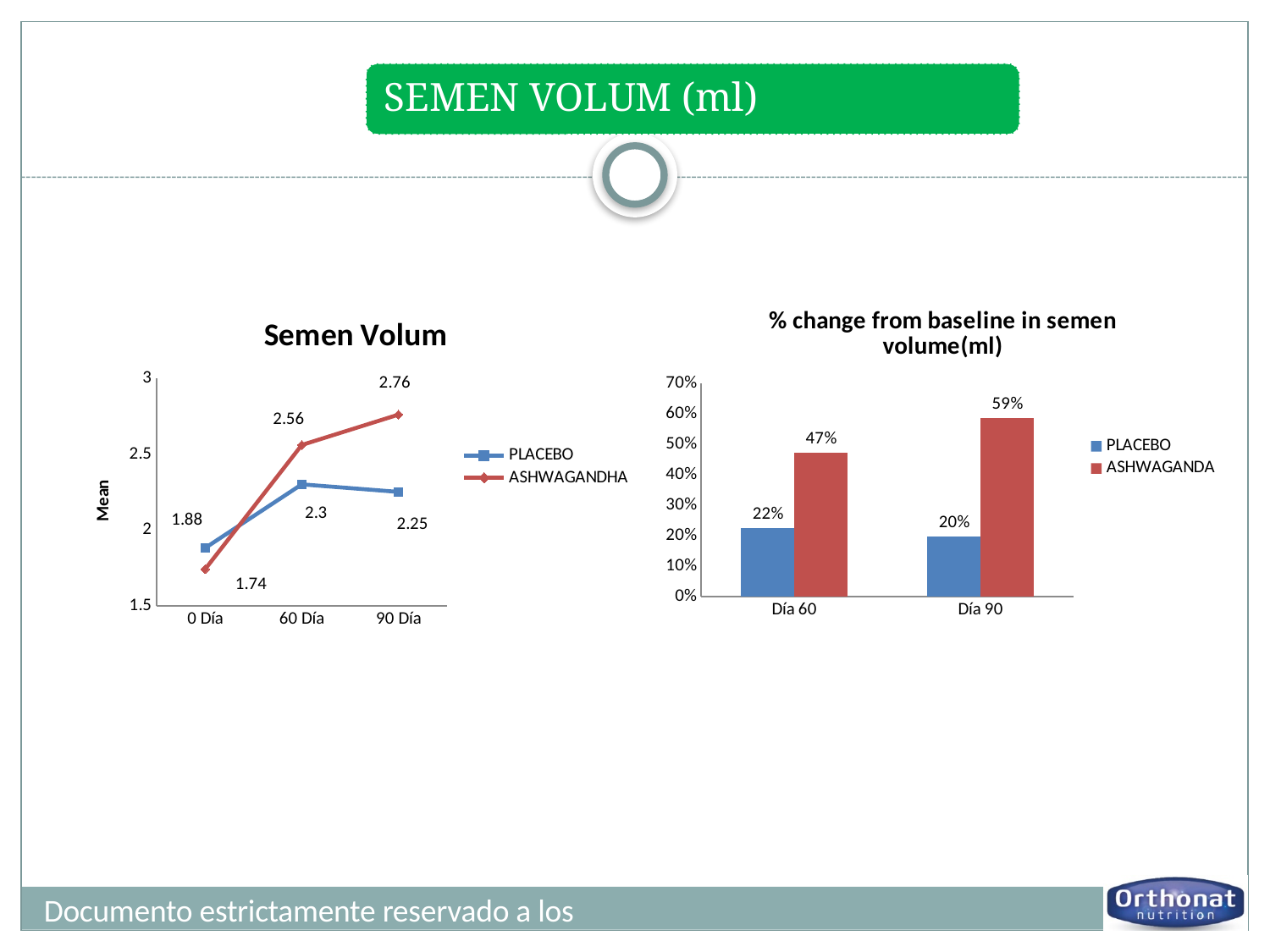
In the 'Semen Volum' chart, which series has the higher value at 90 Día? ASHWAGANDHA In the '% change from baseline in semen volume(ml)' chart, what kind of chart is it? Bar chart In the 'Semen Volum' chart, what is the ASHWAGANDHA value at 90 Día? 2.76 In the 'Semen Volum' chart, does the ASHWAGANDHA series rise or fall from 0 Día to 90 Día? Rise In the 'Semen Volum' chart, how many series does the legend list? 2 In the '% change from baseline in semen volume(ml)' chart, what is the ASHWAGANDA value at Día 90? 59% In the '% change from baseline in semen volume(ml)' chart, what is the PLACEBO value at Día 60? 22% In the 'Semen Volum' chart, what is the PLACEBO value at 0 Día? 1.88 In the 'Semen Volum' chart, what kind of chart is it? Line chart In the '% change from baseline in semen volume(ml)' chart, what is the difference between the ASHWAGANDA and PLACEBO values at Día 90? 39% In the 'Semen Volum' chart, what is the difference between the ASHWAGANDHA and PLACEBO values at 60 Día? 0.26 In the 'Semen Volum' chart, what is the ASHWAGANDHA value at 0 Día? 1.74